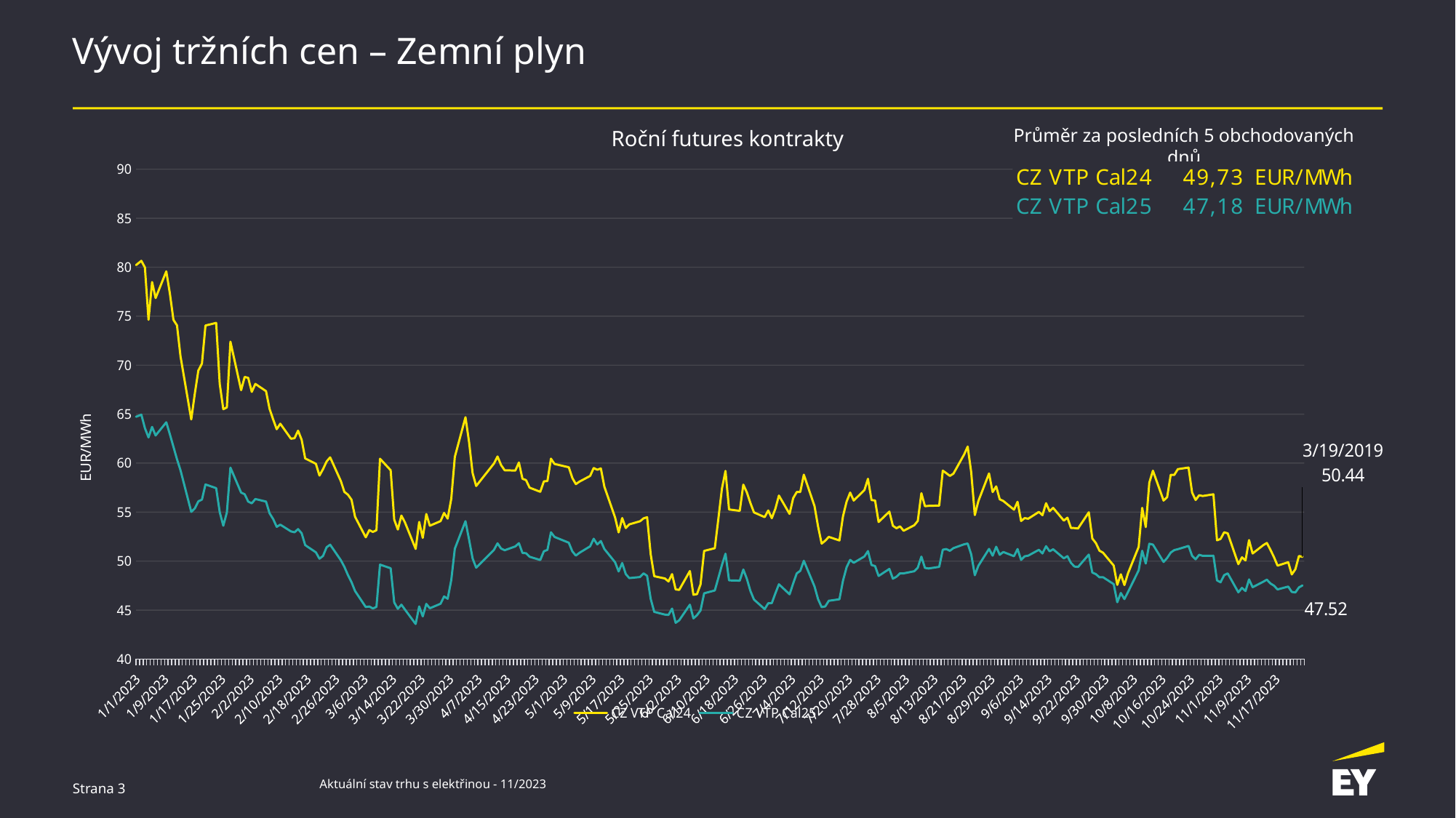
Is the value of CZ VTP Cal24 on 1/1/2023 greater or less than 75? greater Is the value of CZ VTP Cal25 on 1/1/2023 greater or less than 60? greater What is the title of the chart? Roční futures kontrakty Which series reaches the highest value anywhere on the chart? CZ VTP Cal24 How many series does the chart's legend list? 2 What is the average of the last 5 traded days for CZ VTP Cal24 as stated on the slide? 49,73 EUR/MWh What is the last labelled value of the CZ VTP Cal25 series? 47.52 At the end of the chart, which series has the higher value, CZ VTP Cal24 or CZ VTP Cal25? CZ VTP Cal24 What is the difference between the final labelled values of CZ VTP Cal24 (50.44) and CZ VTP Cal25 (47.52)? 2.92 What kind of chart is shown on the slide? line chart What is the last labelled value of the CZ VTP Cal24 series? 50.44 Does the CZ VTP Cal24 series overall rise or fall from 1/1/2023 to 11/17/2023? fall